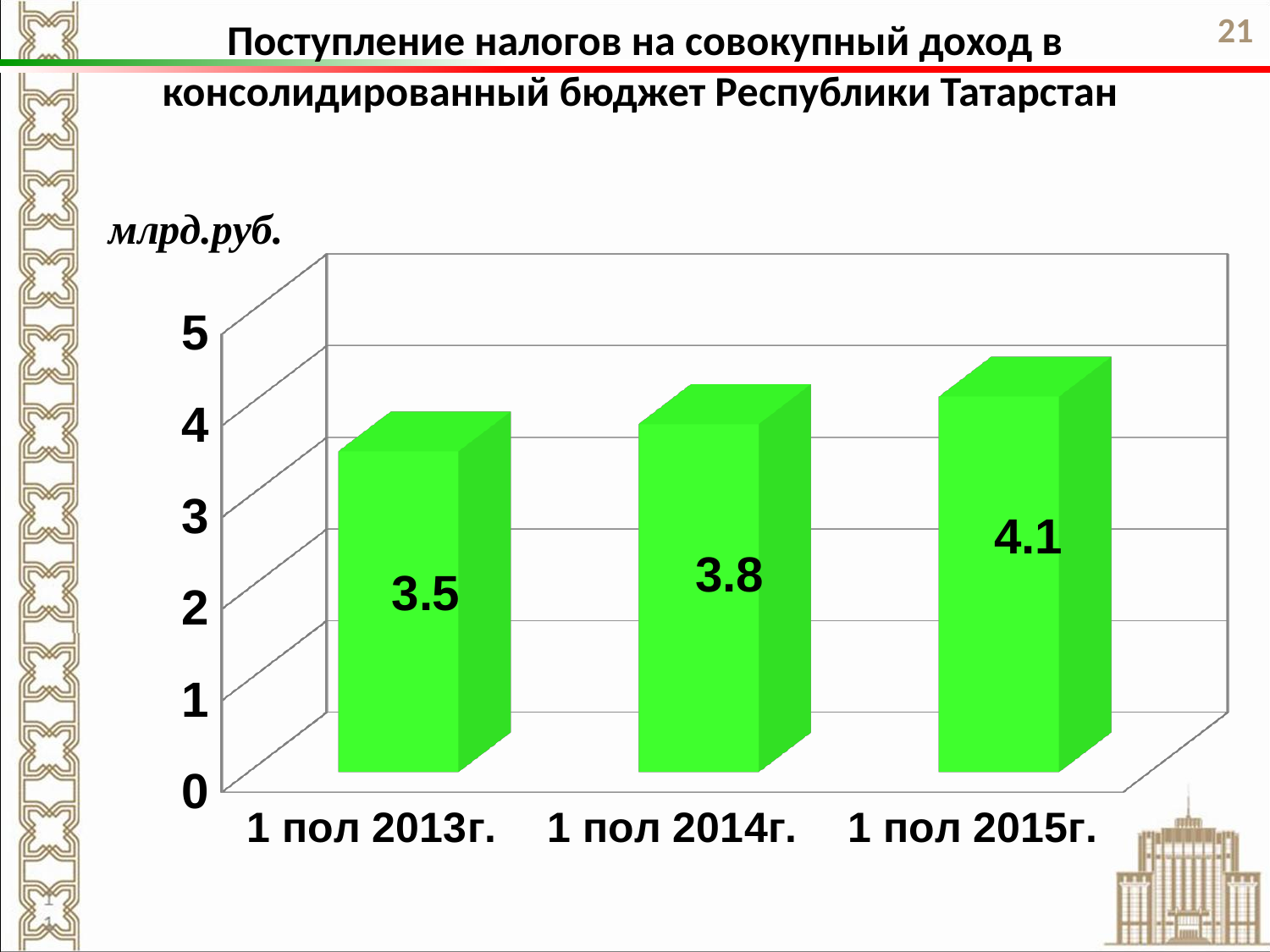
Which period has the lowest value? 1 пол 2013г. What is the value for 1 пол 2014г.? 3.8 Which is larger, the value for 1 пол 2014г. or 1 пол 2015г.? 1 пол 2015г. What is the value for 1 пол 2015г.? 4.1 What is the difference between the values for 1 пол 2014г. and 1 пол 2013г.? 0.3 What kind of chart is shown on the slide? bar chart Do the values rise or fall from 1 пол 2013г. to 1 пол 2015г.? rise Which period has the highest value? 1 пол 2015г. What is the difference between the values for 1 пол 2015г. and 1 пол 2013г.? 0.6 How many bars are shown in the chart? 3 What is the value for 1 пол 2013г.? 3.5 Is the value for 1 пол 2015г. greater or less than 4? greater